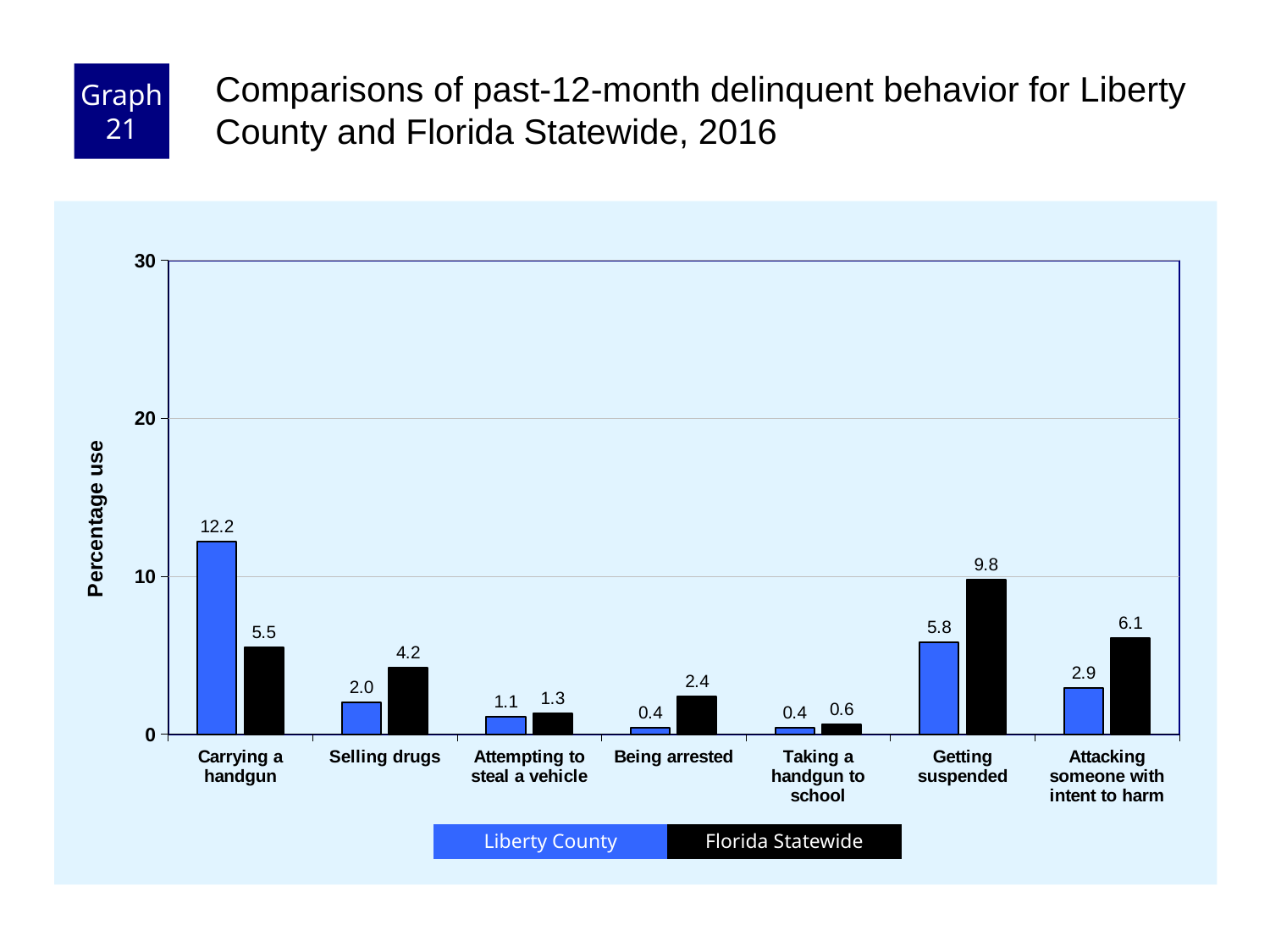
What is the difference between the Florida Statewide and Liberty County values for Getting suspended? 4.0 What is the Florida Statewide value for Being arrested? 2.4 What is the Florida Statewide value for Getting suspended? 9.8 How many series does the legend list? 2 Which is larger for Attacking someone with intent to harm: Liberty County or Florida Statewide? Florida Statewide How many categories are shown on the x axis? 7 Is the Liberty County value for Carrying a handgun greater or less than 10? greater Which category has the highest Liberty County value? Carrying a handgun What is the Liberty County value for Carrying a handgun? 12.2 What kind of chart is shown on the slide? Bar chart What is the difference between the Liberty County and Florida Statewide values for Carrying a handgun? 6.7 Which category has the lowest Florida Statewide value? Taking a handgun to school